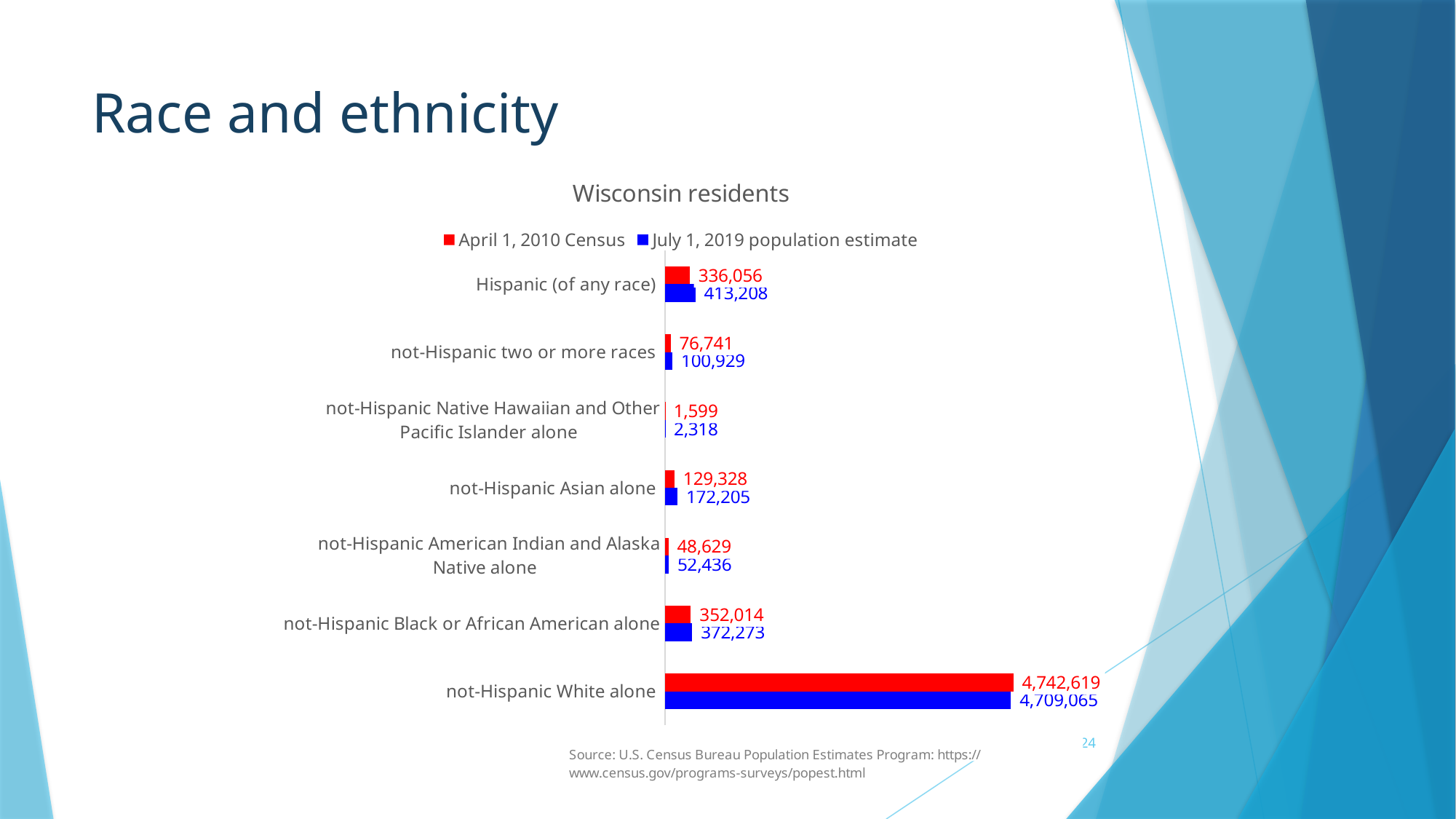
What is the July 1, 2019 population estimate for not-Hispanic Native Hawaiian and Other Pacific Islander alone? 2,318 How many race/ethnicity categories are plotted in the chart? 7 By how much did the Hispanic (of any race) population increase from the April 1, 2010 Census to the July 1, 2019 estimate? 77,152 What kind of chart is shown on the slide? bar chart For not-Hispanic White alone, which is larger: the April 1, 2010 Census value or the July 1, 2019 population estimate? April 1, 2010 Census Which category has the lowest April 1, 2010 Census value? not-Hispanic Native Hawaiian and Other Pacific Islander alone How many series does the legend list? 2 What is the July 1, 2019 population estimate for not-Hispanic Asian alone? 172,205 What is the title of the chart? Wisconsin residents Which category has the highest July 1, 2019 population estimate? not-Hispanic White alone What colour represents the July 1, 2019 population estimate series? blue What is the April 1, 2010 Census value for Hispanic (of any race)? 336,056